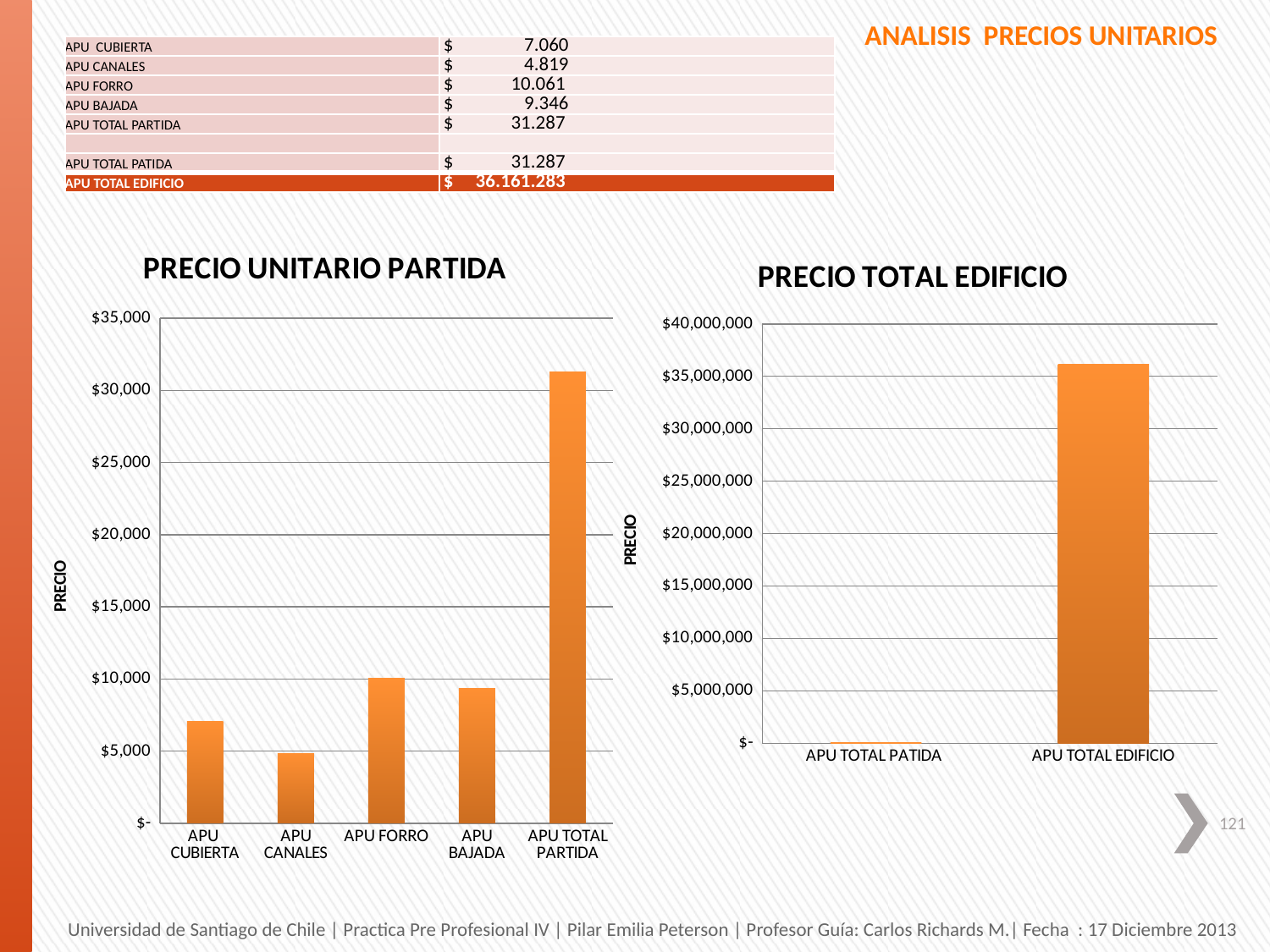
In the PRECIO TOTAL EDIFICIO chart, is the value for APU TOTAL EDIFICIO greater or less than $35,000,000? greater What kind of chart is the PRECIO UNITARIO PARTIDA chart? bar chart In the PRECIO UNITARIO PARTIDA chart, which category has the highest value? APU TOTAL PARTIDA In the PRECIO UNITARIO PARTIDA chart, is the value for APU CUBIERTA greater or less than $5,000? greater In the PRECIO TOTAL EDIFICIO chart, which category has the highest value? APU TOTAL EDIFICIO In the PRECIO UNITARIO PARTIDA chart, is the value for APU BAJADA greater or less than $10,000? less How many categories are shown on the x axis of the PRECIO UNITARIO PARTIDA chart? 5 What is the title of the y axis on the PRECIO TOTAL EDIFICIO chart? PRECIO In the PRECIO UNITARIO PARTIDA chart, which category has the lowest value? APU CANALES How many categories are shown in the PRECIO TOTAL EDIFICIO chart? 2 In the PRECIO UNITARIO PARTIDA chart, which is larger, APU FORRO or APU BAJADA? APU FORRO